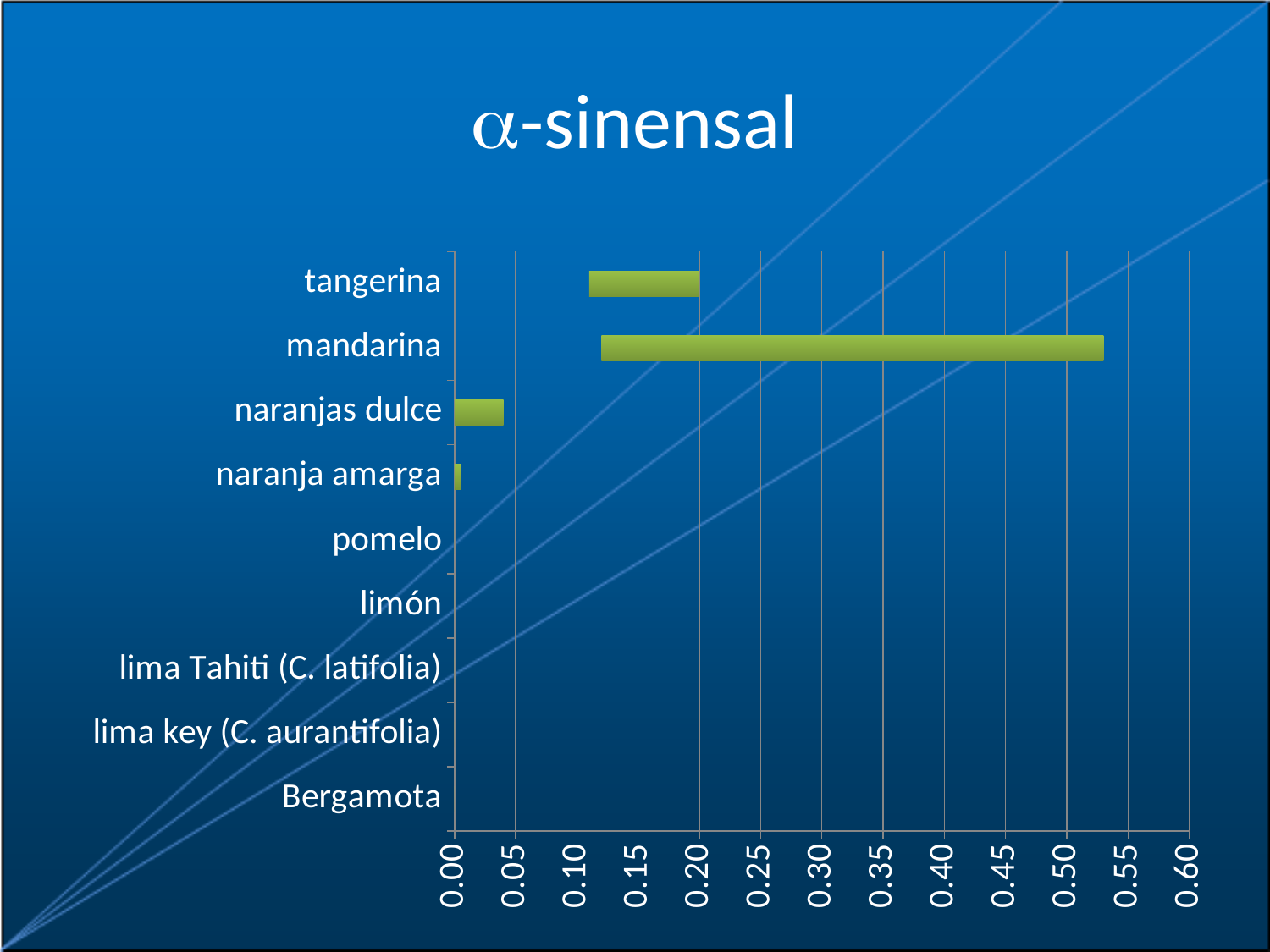
How many categories show no visible bar at all? 5 Which has the longer bar, naranjas dulce or naranja amarga? naranjas dulce What kind of chart is shown on the slide? bar chart What is the title of the chart? α-sinensal Which category has the longest bar in the chart? mandarina Does the bar for tangerina reach a value greater or less than 0.15? greater Does the bar for mandarina extend beyond 0.50 on the axis, greater or less? greater Which category is listed at the bottom of the vertical axis? Bergamota Is the value for naranjas dulce greater or less than 0.05? less What is the highest value shown on the horizontal axis? 0.60 Which bar extends further to the right, mandarina or tangerina? mandarina How many categories are listed on the vertical axis of the chart? 9